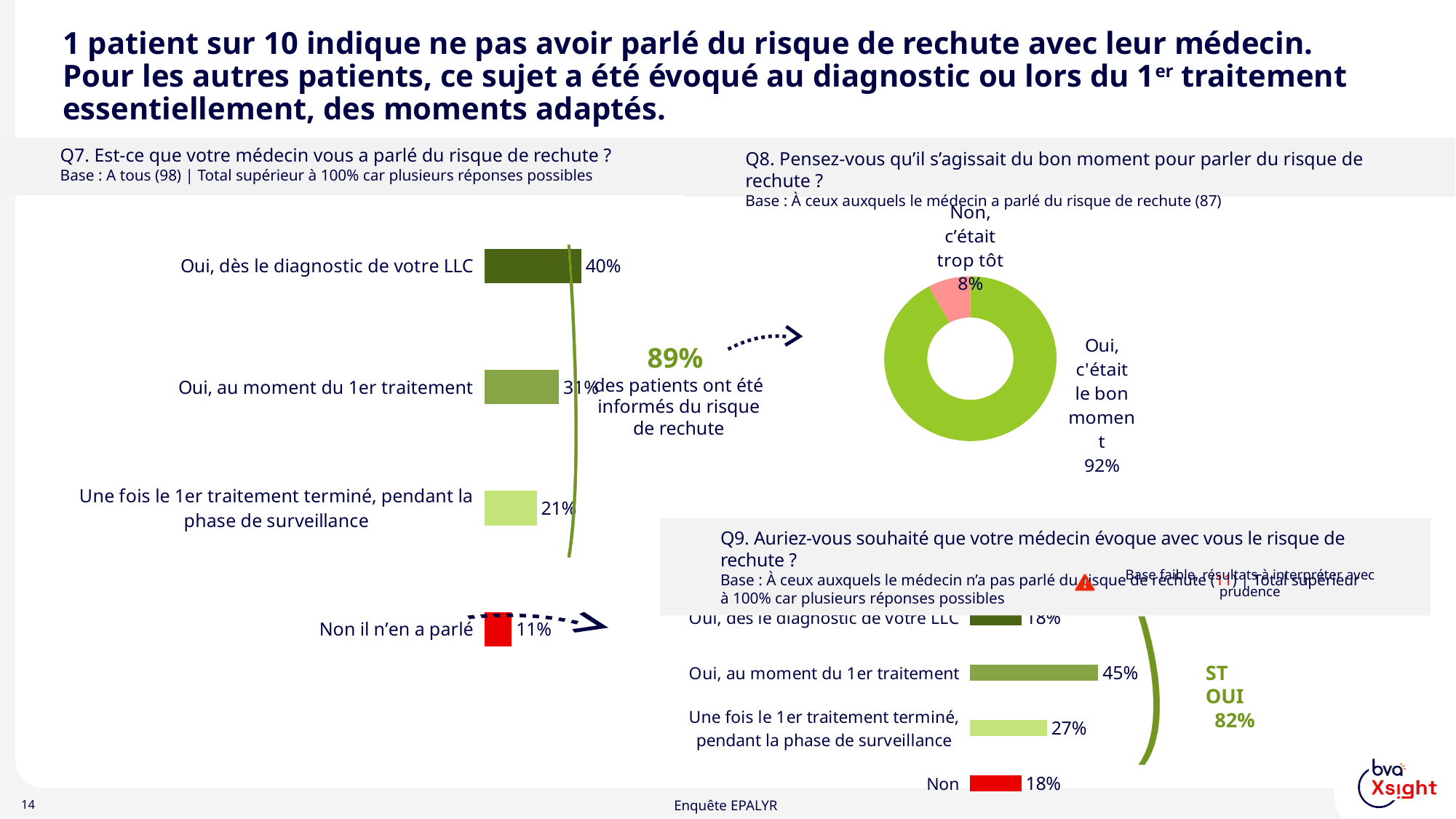
In the Q9 chart, is the value for 'Oui, au moment du 1er traitement' larger or smaller than the value for 'Non'? Larger In the Q9 chart, what is the value for 'Une fois le 1er traitement terminé, pendant la phase de surveillance'? 27% In the Q7 chart, what percentage of patients said their doctor talked about the risk of relapse at the diagnosis of their LLC? 40% In the Q8 donut chart, what share of patients said it was the right moment ('Oui, c'était le bon moment')? 92% In the Q7 chart, what is the difference between 'Oui, dès le diagnostic de votre LLC' and 'Oui, au moment du 1er traitement'? 9% In the Q9 chart, which category has the highest value? Oui, au moment du 1er traitement What type of chart is used for Q8? Donut chart In the Q9 chart, what is the 'ST OUI' total shown next to the bars? 82% In the Q7 chart, how many categories are shown? 4 In the Q7 chart, what percentage corresponds to 'Non il n'en a parlé'? 11% In the Q8 donut chart, what percentage said 'Non, c'était trop tôt'? 8% In the Q7 chart, which category has the highest value? Oui, dès le diagnostic de votre LLC